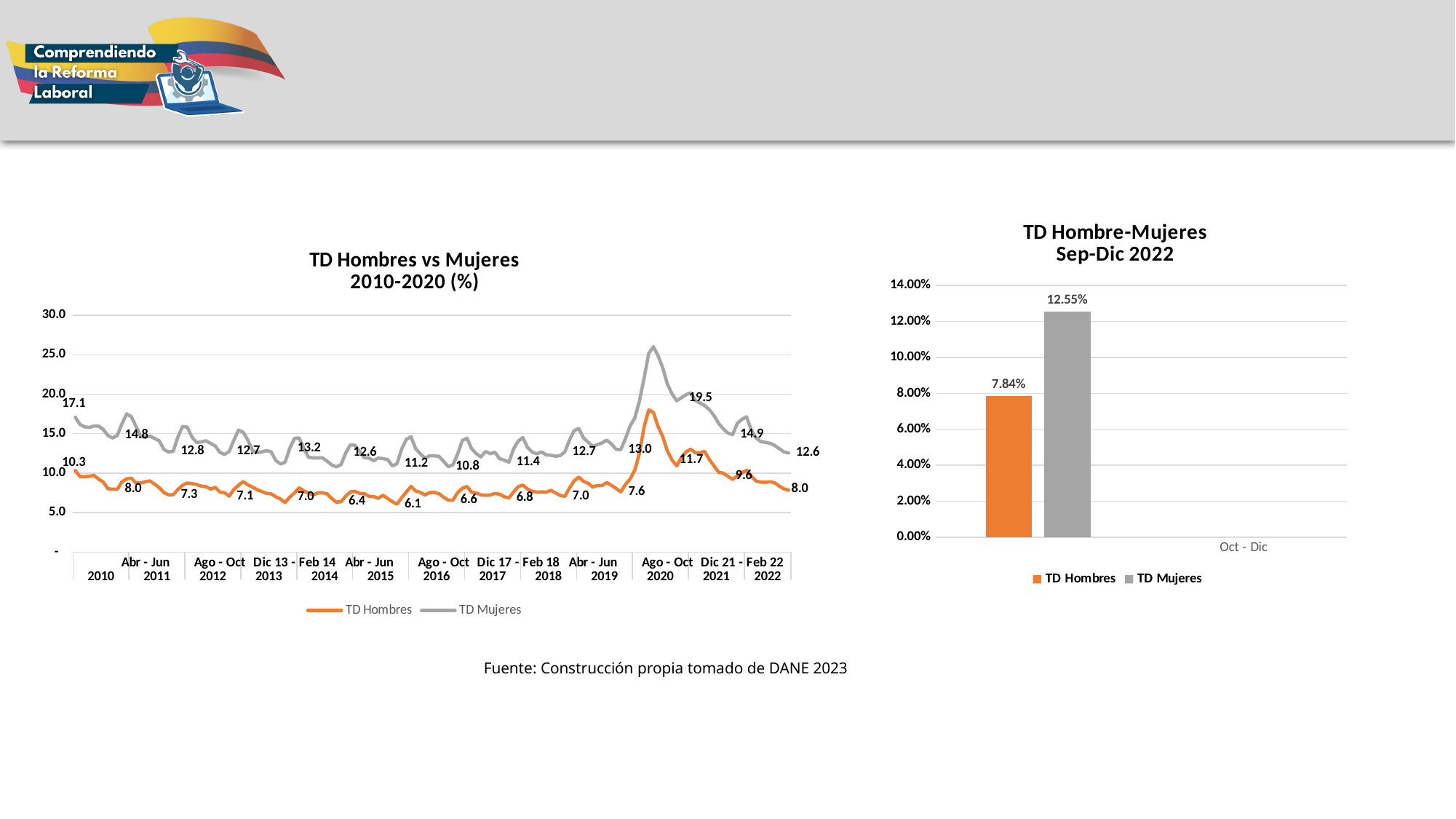
In the 'TD Hombres vs Mujeres 2010-2020 (%)' chart, what is the last labeled value of the TD Mujeres line, at Feb 22 2022? 12.6 In the 'TD Hombre-Mujeres Sep-Dic 2022' chart, which is larger, TD Hombres or TD Mujeres? TD Mujeres In the 'TD Hombre-Mujeres Sep-Dic 2022' chart, what is the value for TD Hombres? 7.84% In the 'TD Hombres vs Mujeres 2010-2020 (%)' chart, what is the first labeled value of the TD Mujeres line, at 2010? 17.1 In the 'TD Hombre-Mujeres Sep-Dic 2022' chart, what is the difference between TD Mujeres and TD Hombres? 4.71% What kind of chart is the 'TD Hombres vs Mujeres 2010-2020 (%)' chart on the left? line chart How many series does the legend of the 'TD Hombres vs Mujeres 2010-2020 (%)' chart list? 2 What kind of chart is the 'TD Hombre-Mujeres Sep-Dic 2022' chart on the right? bar chart In the 'TD Hombres vs Mujeres 2010-2020 (%)' chart, what is the last labeled value of the TD Hombres line, at Feb 22 2022? 8.0 In the 'TD Hombres vs Mujeres 2010-2020 (%)' chart, which series stays higher across the whole period, TD Hombres or TD Mujeres? TD Mujeres In the 'TD Hombre-Mujeres Sep-Dic 2022' chart, what is the value for TD Mujeres? 12.55% How many series does the legend of the 'TD Hombre-Mujeres Sep-Dic 2022' chart list? 2